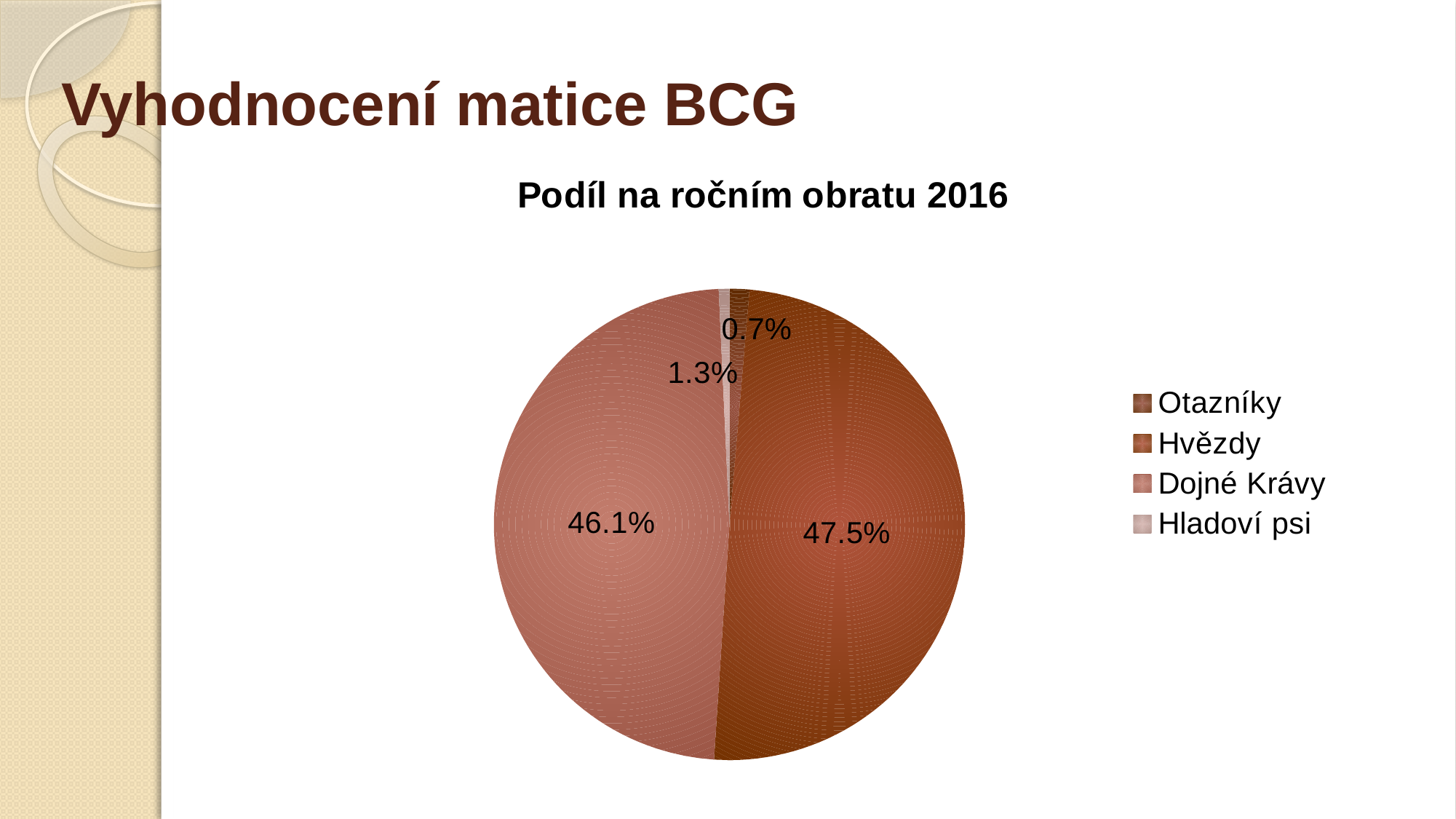
Which category has the smallest share of the pie? Hladoví psi Which category has the largest share of the pie? Hvězdy What share of the pie does Hvězdy have? 47.5% What share of the pie does Dojné Krávy have? 46.1% What kind of chart is shown on the slide? Pie chart What share of the pie does Hladoví psi have? 0.7% What is the title of the chart? Podíl na ročním obratu 2016 What share of the pie does Otazníky have? 1.3% Which has a larger share, Hladoví psi or Otazníky? Otazníky What is the combined share of Hvězdy and Dojné Krávy? 93.6% How many categories does the legend list? 4 What is the difference in percentage points between the Hvězdy and Dojné Krávy shares? 1.4